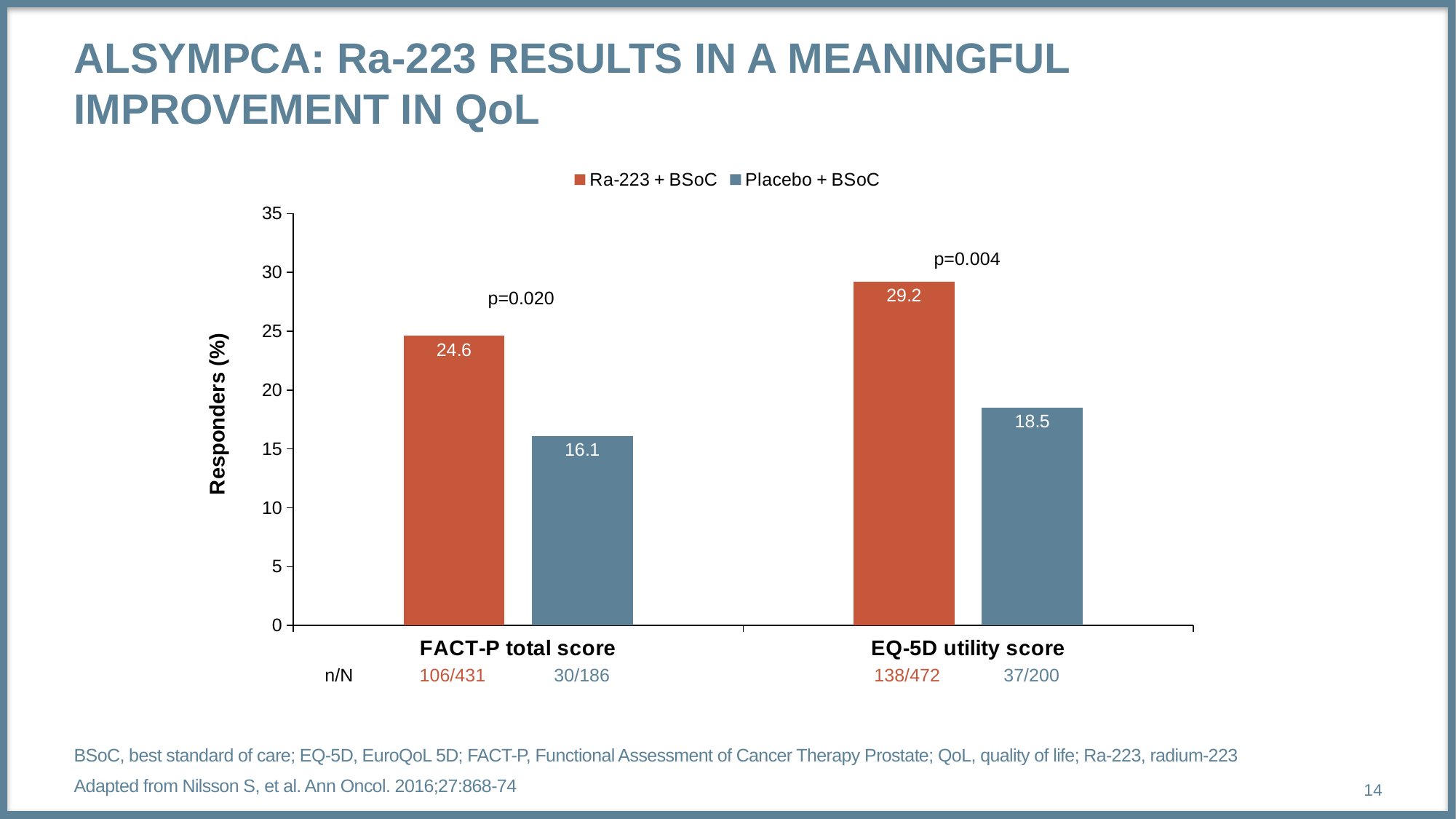
How many series does the legend list? 2 What is the value for Placebo + BSoC for EQ-5D utility score? 18.5 Which is larger for FACT-P total score: Ra-223 + BSoC or Placebo + BSoC? Ra-223 + BSoC What is the value for Placebo + BSoC for FACT-P total score? 16.1 Which bar has the highest value on the chart? Ra-223 + BSoC, EQ-5D utility score What is the label of the y axis? Responders (%) Which bar has the lowest value on the chart? Placebo + BSoC, FACT-P total score What is the difference between Ra-223 + BSoC and Placebo + BSoC for EQ-5D utility score? 10.7 What is the difference between Ra-223 + BSoC and Placebo + BSoC for FACT-P total score? 8.5 What is the value for Ra-223 + BSoC for FACT-P total score? 24.6 What kind of chart is shown on the slide? Bar chart How many categories are shown on the x axis? 2